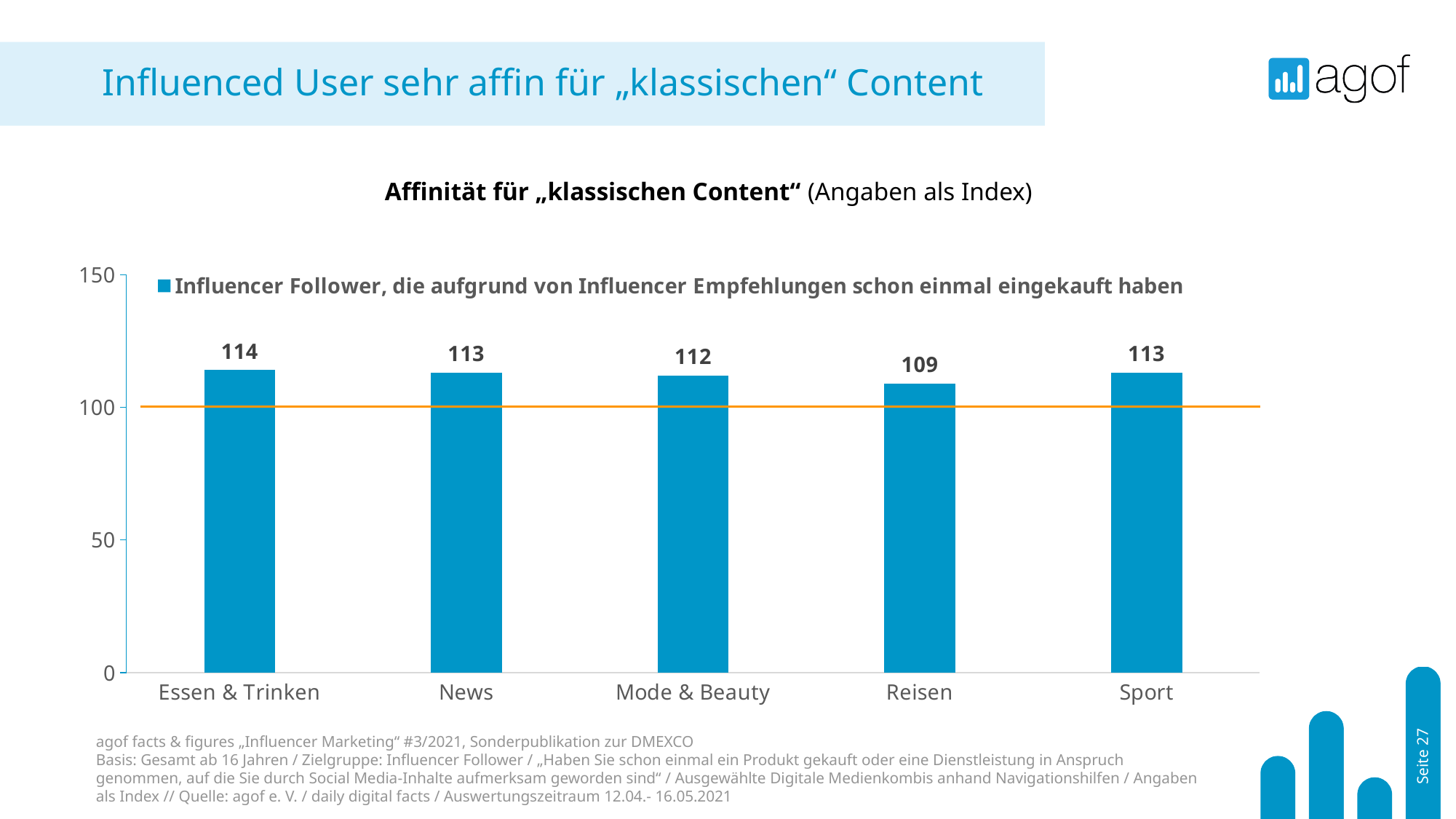
How many series does the legend list? 1 Which category has the highest index value? Essen & Trinken Which category has the lowest index value? Reisen What kind of chart is shown on the slide? bar chart What is the difference between the index values for Essen & Trinken and Reisen? 5 What is the index value for Reisen? 109 What is the index value for Mode & Beauty? 112 How many categories are shown on the x axis? 5 Is the value for Sport greater or less than 100? greater Which has a higher index value, News or Reisen? News What is the index value for Essen & Trinken? 114 What is the title of the chart? Affinität für „klassischen Content“ (Angaben als Index)